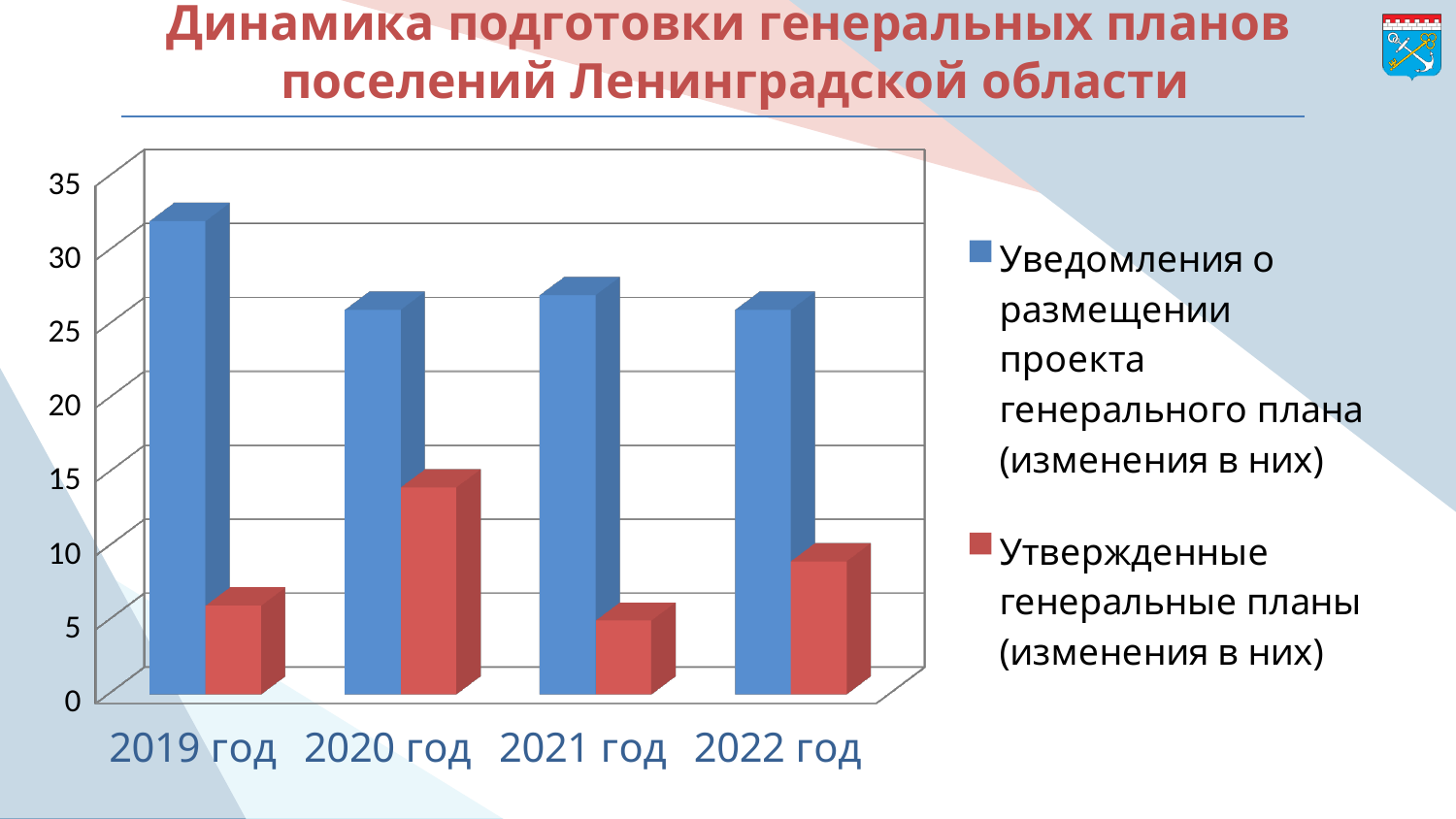
Does the value for «Уведомления о размещении проекта генерального плана» rise or fall from 2019 год to 2020 год? fall Is the value for «Утвержденные генеральные планы» in 2020 год greater or less than 10? greater Which year has the highest value for «Уведомления о размещении проекта генерального плана (изменения в них)»? 2019 год Is the value for «Утвержденные генеральные планы» in 2021 год greater or less than 10? less Is the value for «Уведомления о размещении проекта генерального плана» in 2021 год greater or less than 25? greater Which is larger: «Утвержденные генеральные планы» in 2020 год or in 2022 год? 2020 год Which is larger: «Уведомления о размещении проекта генерального плана» in 2019 год or in 2020 год? 2019 год How many years (categories) are shown on the x axis? 4 How many series does the legend list? 2 Which year has the highest value for «Утвержденные генеральные планы (изменения в них)»? 2020 год What kind of chart is shown on the slide? Bar chart